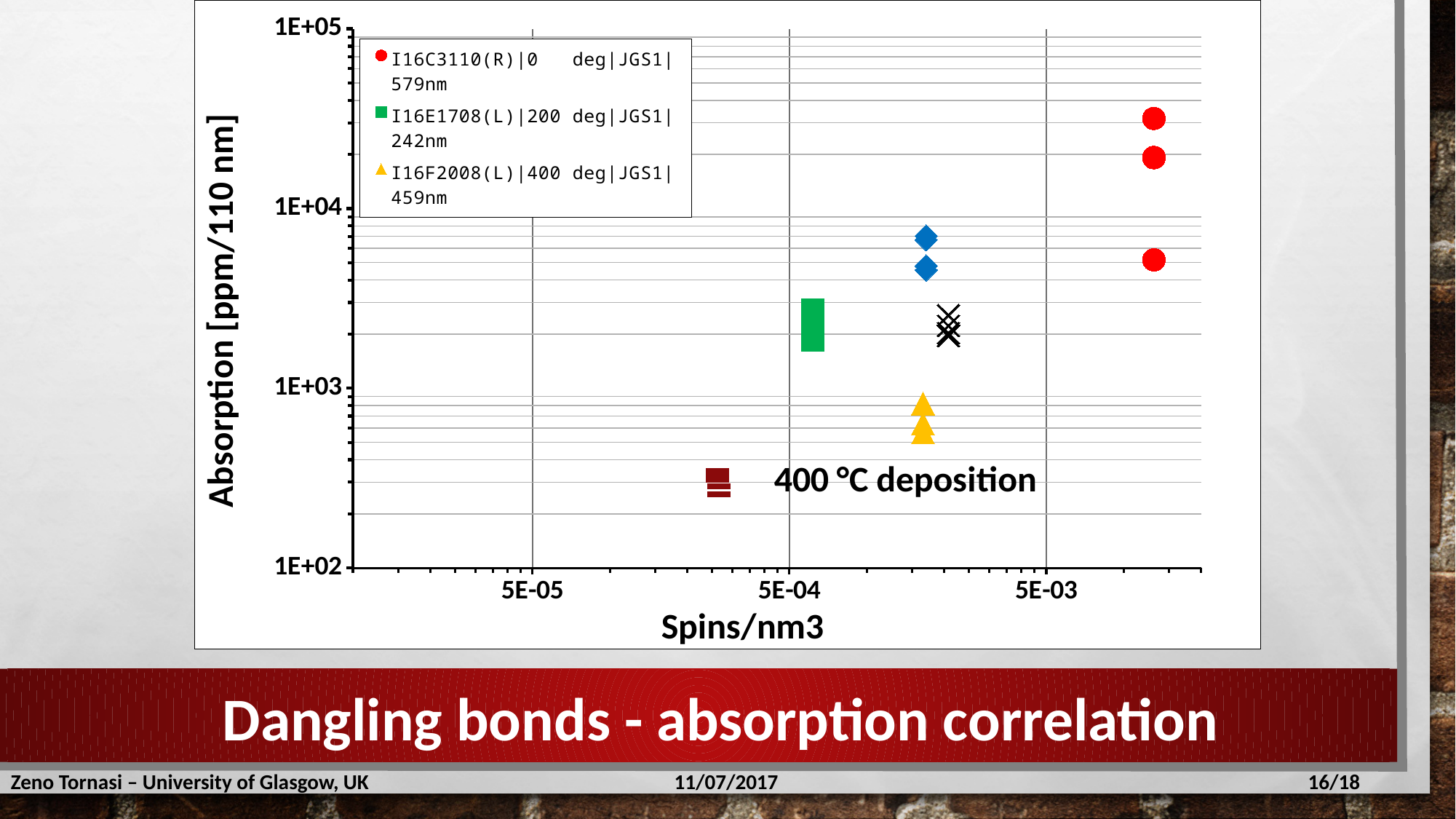
Which legend series has the lowest absorption values? I16F2008(L)|400 deg|JGS1|459nm Are the Spins/nm3 values for I16F2008(L)|400 deg|JGS1|459nm greater or less than 5E-03? less Which series has higher absorption, I16E1708(L)|200 deg|JGS1|242nm or I16F2008(L)|400 deg|JGS1|459nm? I16E1708(L)|200 deg|JGS1|242nm Are the absorption values for I16C3110(R)|0 deg|JGS1|579nm greater or less than 1E+03? greater Which legend series has the highest absorption values? I16C3110(R)|0 deg|JGS1|579nm What is the label of the y axis? Absorption [ppm/110 nm] What is the label of the x axis? Spins/nm3 What kind of chart is shown on the slide? Scatter chart Are the absorption values for I16F2008(L)|400 deg|JGS1|459nm greater or less than 1E+03? less How many series does the legend list? 3